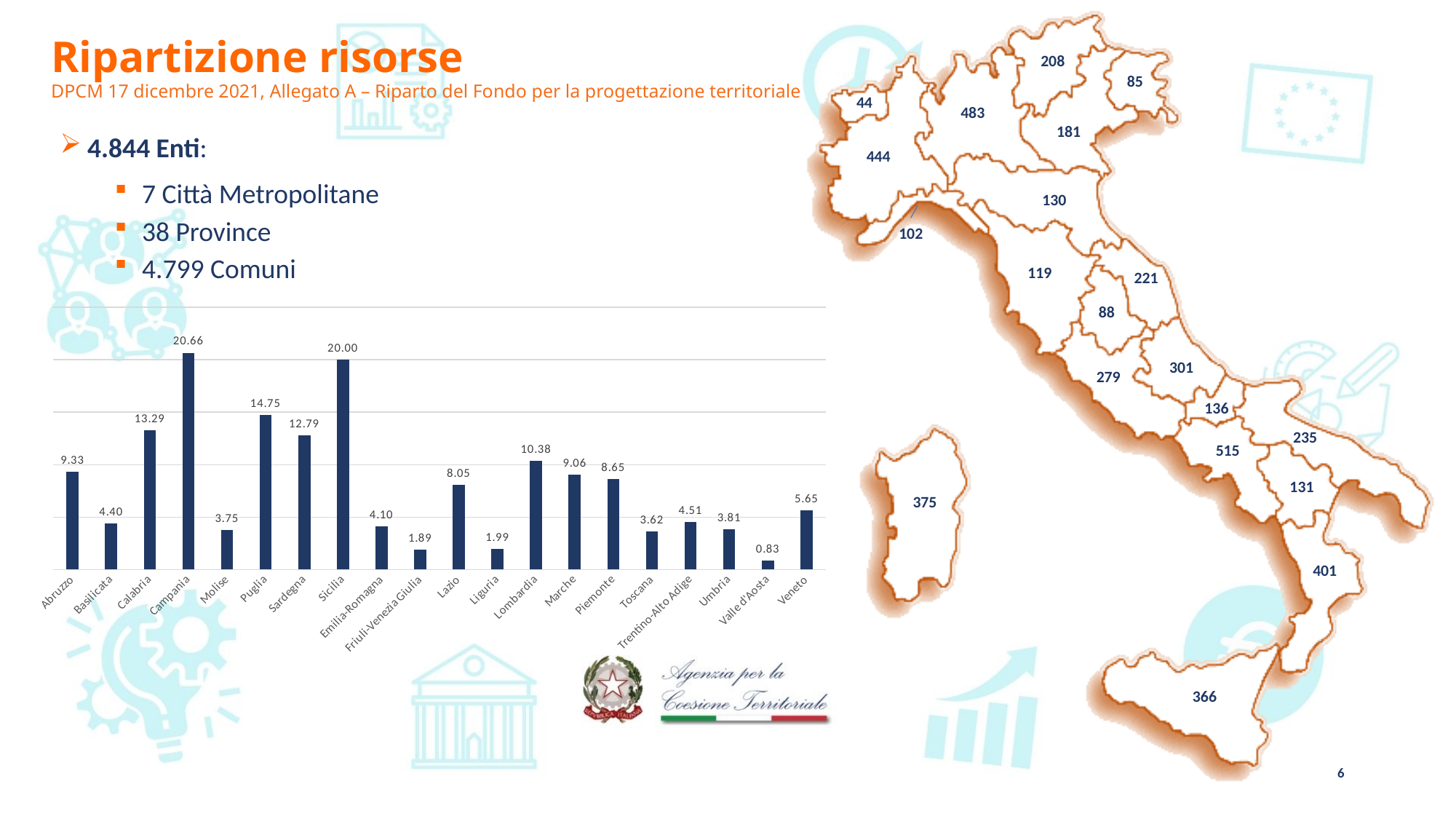
What is the value shown for Valle d'Aosta in the bar chart? 0.83 Which region has the highest value in the bar chart? Campania Which region has the lowest value in the bar chart? Valle d'Aosta What is the difference between the values for Puglia and Calabria in the bar chart? 1.46 What is the value shown for Campania in the bar chart? 20.66 What is the value shown for Lombardia in the bar chart? 10.38 Which has a larger value in the bar chart, Marche or Piemonte? Marche What is the difference between the values for Campania and Sicilia in the bar chart? 0.66 How many regions are shown in the bar chart? 20 What type of chart is shown on the slide? Bar chart Which has a larger value in the bar chart, Lazio or Abruzzo? Abruzzo What is the value shown for Sicilia in the bar chart? 20.00